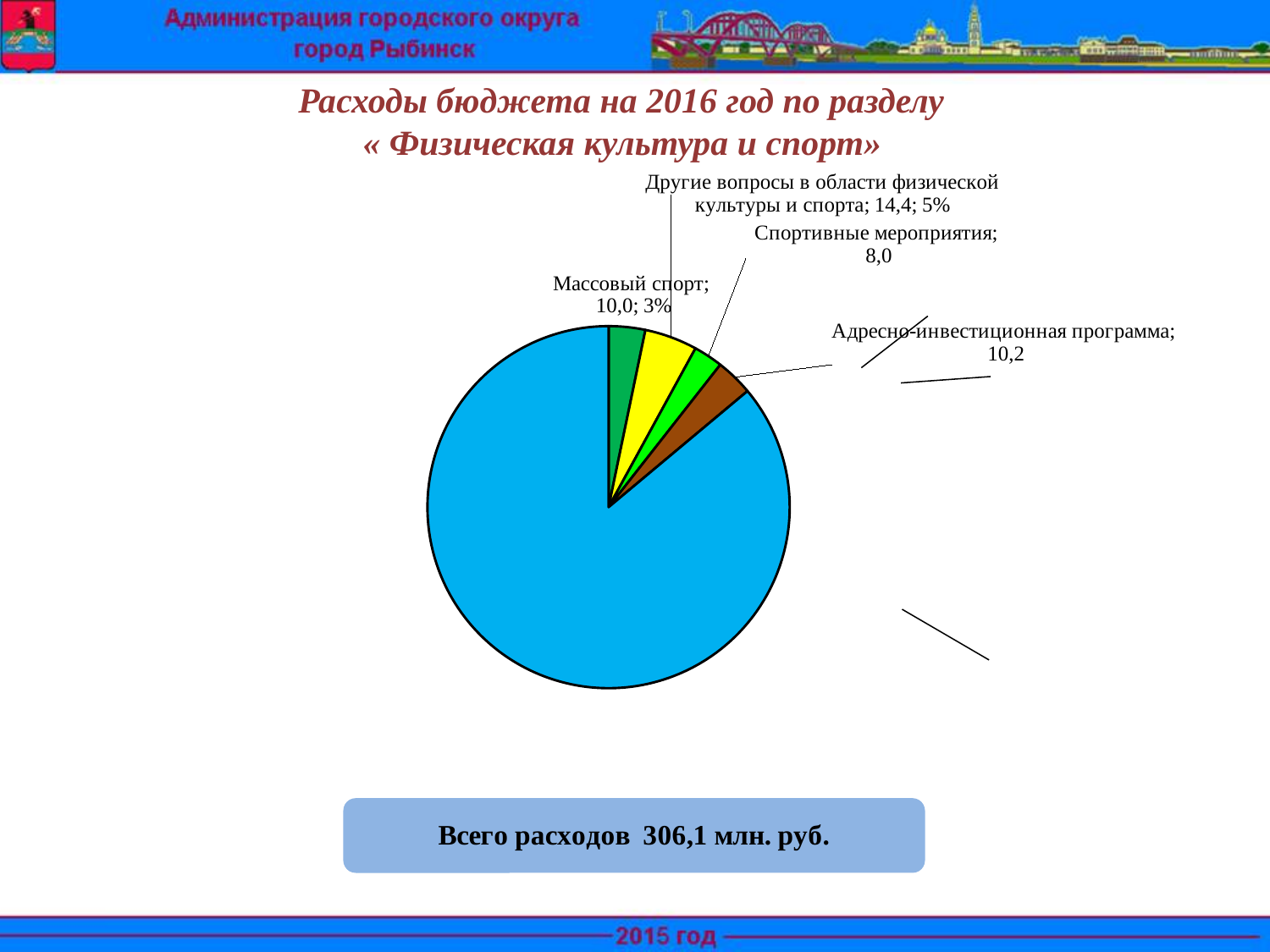
What kind of chart is shown on the slide? pie chart How many slices does the pie chart have? 5 What is the value for «Спортивные мероприятия»? 8,0 Which is larger, «Другие вопросы в области физической культуры и спорта» or «Спортивные мероприятия»? Другие вопросы в области физической культуры и спорта What is the value for «Другие вопросы в области физической культуры и спорта»? 14,4 What is the difference between «Другие вопросы в области физической культуры и спорта» and «Спортивные мероприятия»? 6,4 Which of the labelled slices has the smallest value? Спортивные мероприятия What is the value for «Адресно-инвестиционная программа»? 10,2 What share of the pie does «Другие вопросы в области физической культуры и спорта» represent? 5% What total expenditure is stated below the chart? 306,1 млн. руб. What is the value for «Массовый спорт»? 10,0 What share of the pie does «Массовый спорт» represent? 3%